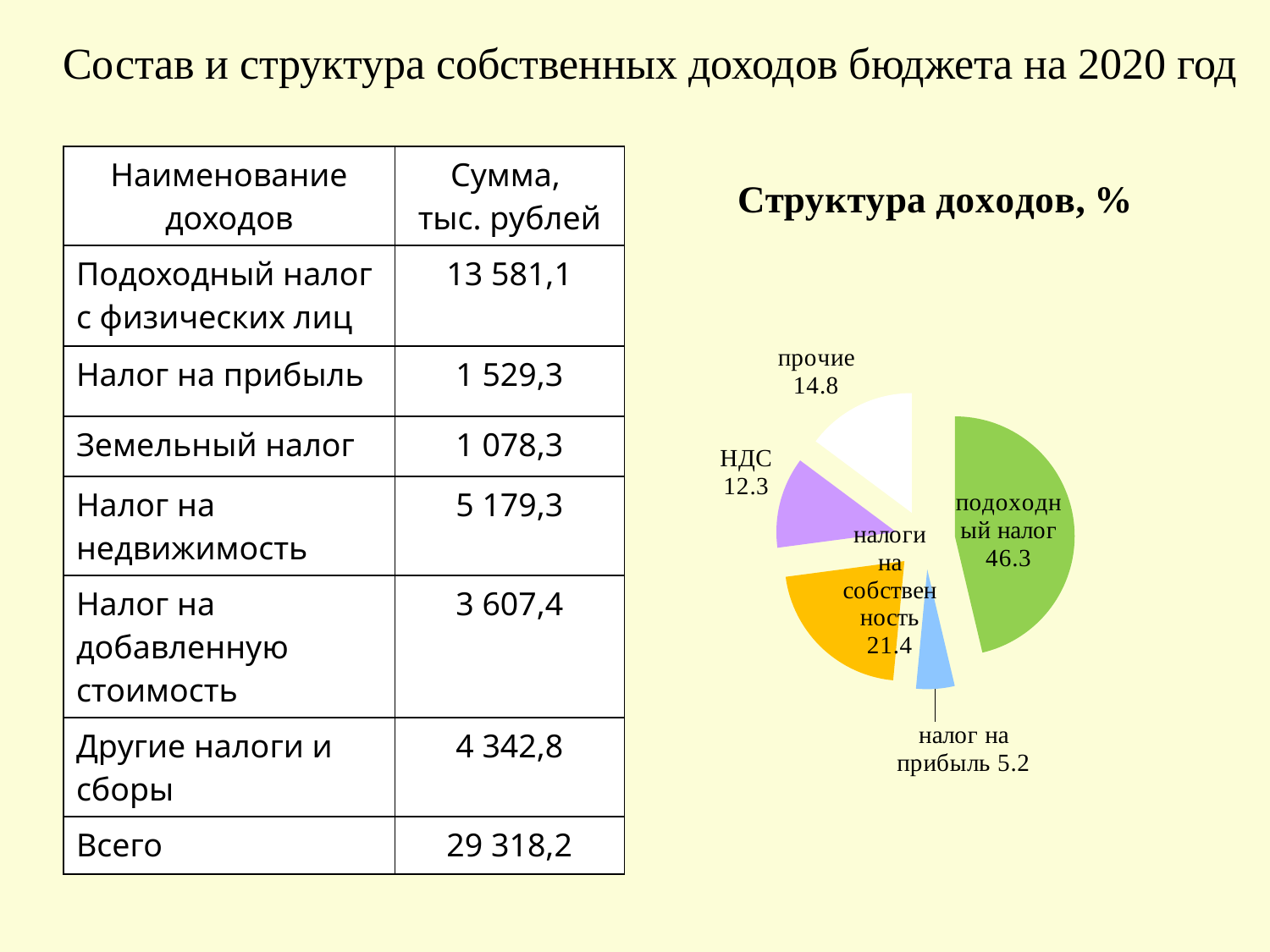
Which is larger in the pie chart, прочие or НДС? прочие What is the difference between the values for подоходный налог and налоги на собственность? 24.9 What is the value for налоги на собственность in the pie chart? 21.4 Which slice of the pie chart is the smallest? налог на прибыль How many slices does the pie chart have? 5 What is the title of the chart? Структура доходов, % What is the value for НДС in the pie chart? 12.3 What kind of chart is shown on the slide? pie chart What is the value for налог на прибыль in the pie chart? 5.2 What is the value for прочие in the pie chart? 14.8 Which slice of the pie chart is the largest? подоходный налог What is the value for подоходный налог in the pie chart? 46.3